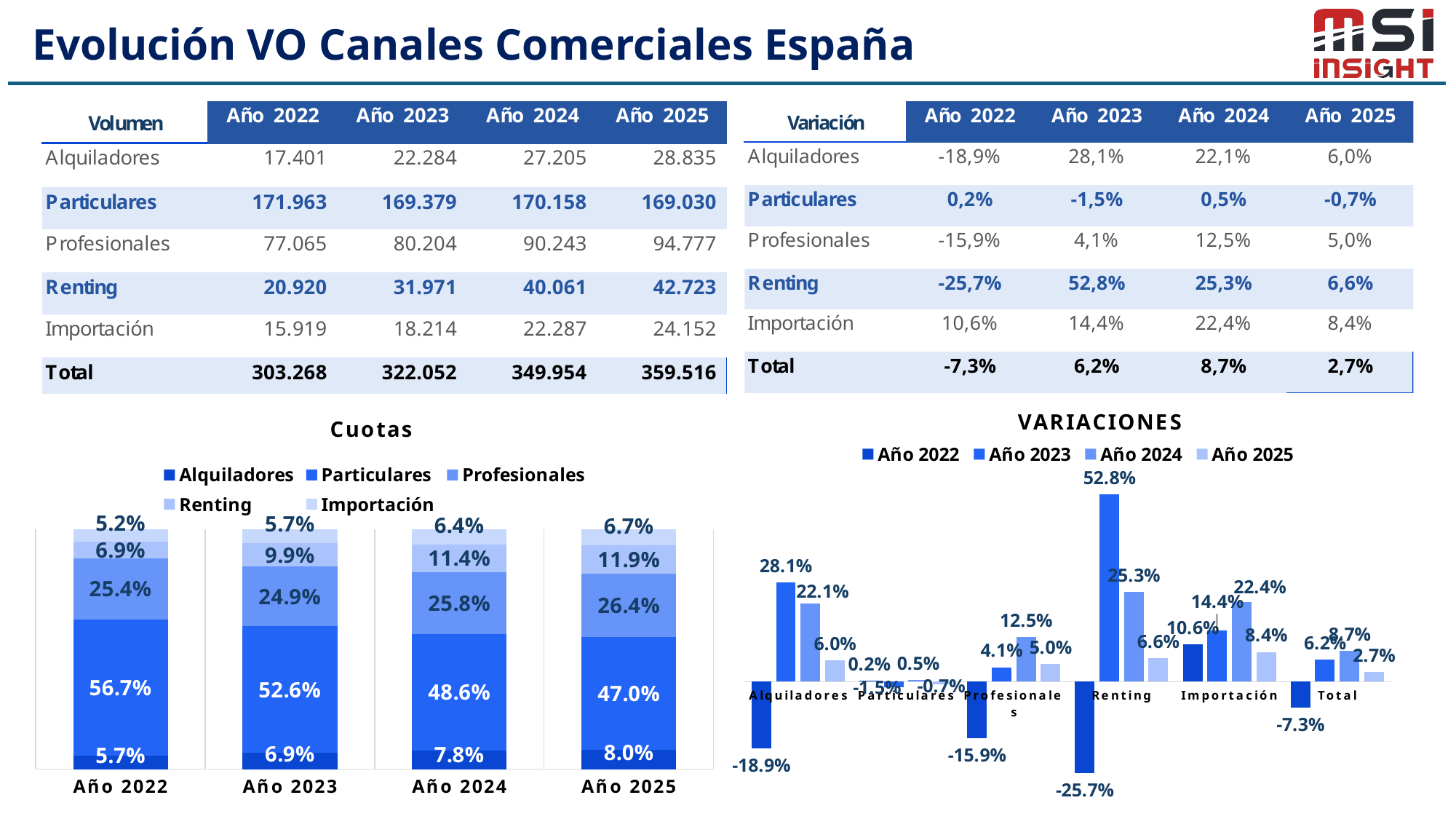
In the Cuotas chart, how many series does the legend list? 5 In the Cuotas chart, what is the share for Renting in Año 2025? 11.9% In the VARIACIONES chart, which is larger for Año 2024: Importación or Profesionales? Importación What kind of chart is the Cuotas chart? Stacked bar chart In the VARIACIONES chart, what is the value for Renting in Año 2023? 52.8% In the VARIACIONES chart, which category and year has the highest value overall? Renting, Año 2023 In the Cuotas chart, does the Particulares share rise or fall from Año 2022 to Año 2025? Fall In the Cuotas chart, how many stacked bars (years) are shown? 4 In the VARIACIONES chart, what is the difference between the Alquiladores values for Año 2023 and Año 2024? 6.0 percentage points In the VARIACIONES chart, which category has the lowest value for Año 2022? Renting In the Cuotas chart, what is the share for Particulares in Año 2022? 56.7% In the Cuotas chart, what is the difference between the Alquiladores share in Año 2025 and in Año 2022? 2.3 percentage points